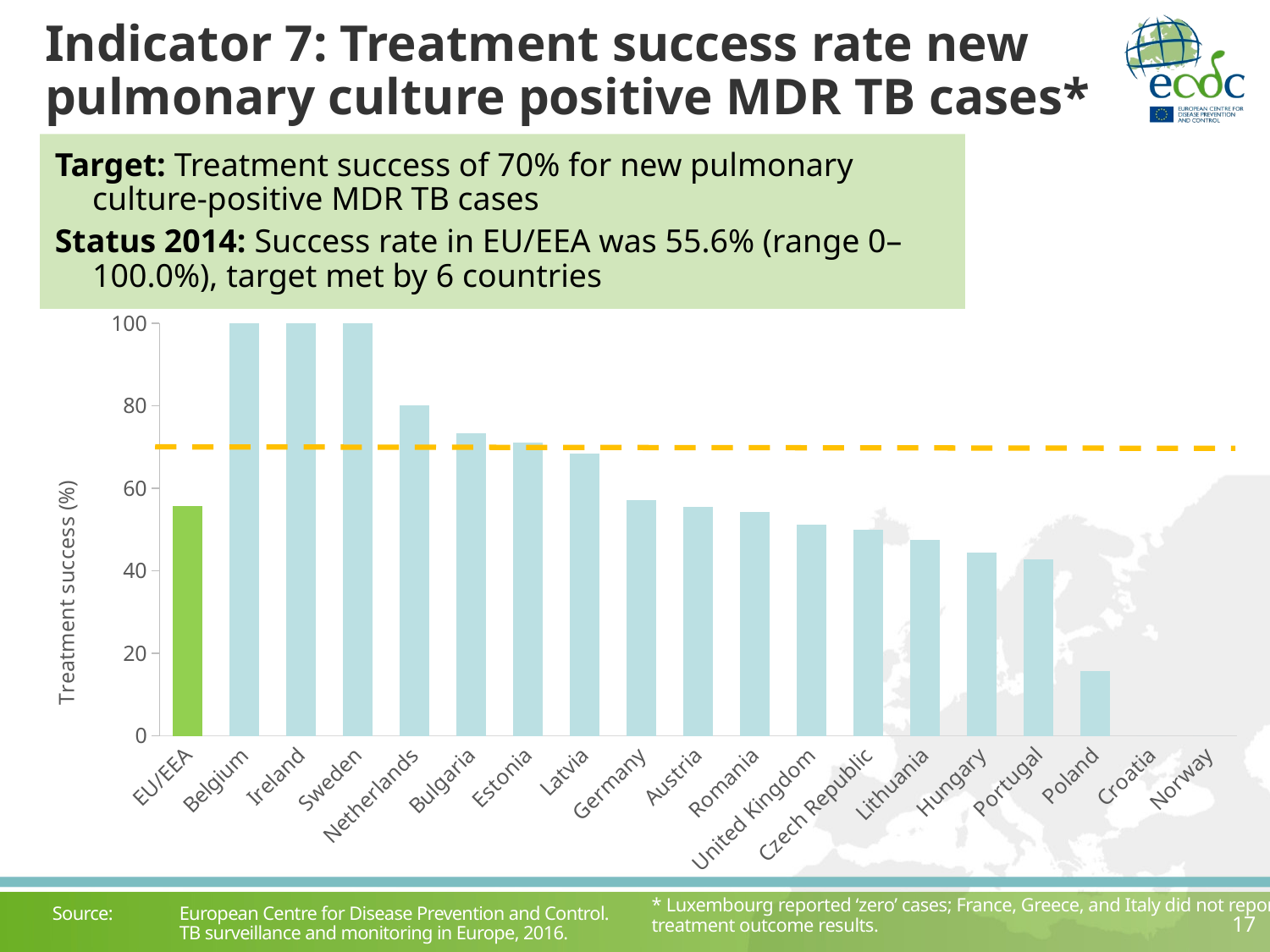
Is the value for Poland greater or less than 20? less Is the value for Latvia greater or less than 60? greater What is the label on the y axis of the chart? Treatment success (%) What is the treatment success value for the Netherlands? 80 Which countries have the lowest treatment success in the chart? Croatia and Norway Is the value for Germany greater or less than 60? less What is the treatment success value for Belgium? 100 What is the difference between the treatment success values for Belgium and the Netherlands? 20 Which has a higher treatment success, Austria or Hungary? Austria What kind of chart is shown on the slide? bar chart Which countries have the highest treatment success in the chart? Belgium, Ireland and Sweden How many categories (bars) are shown along the x axis of the chart? 19